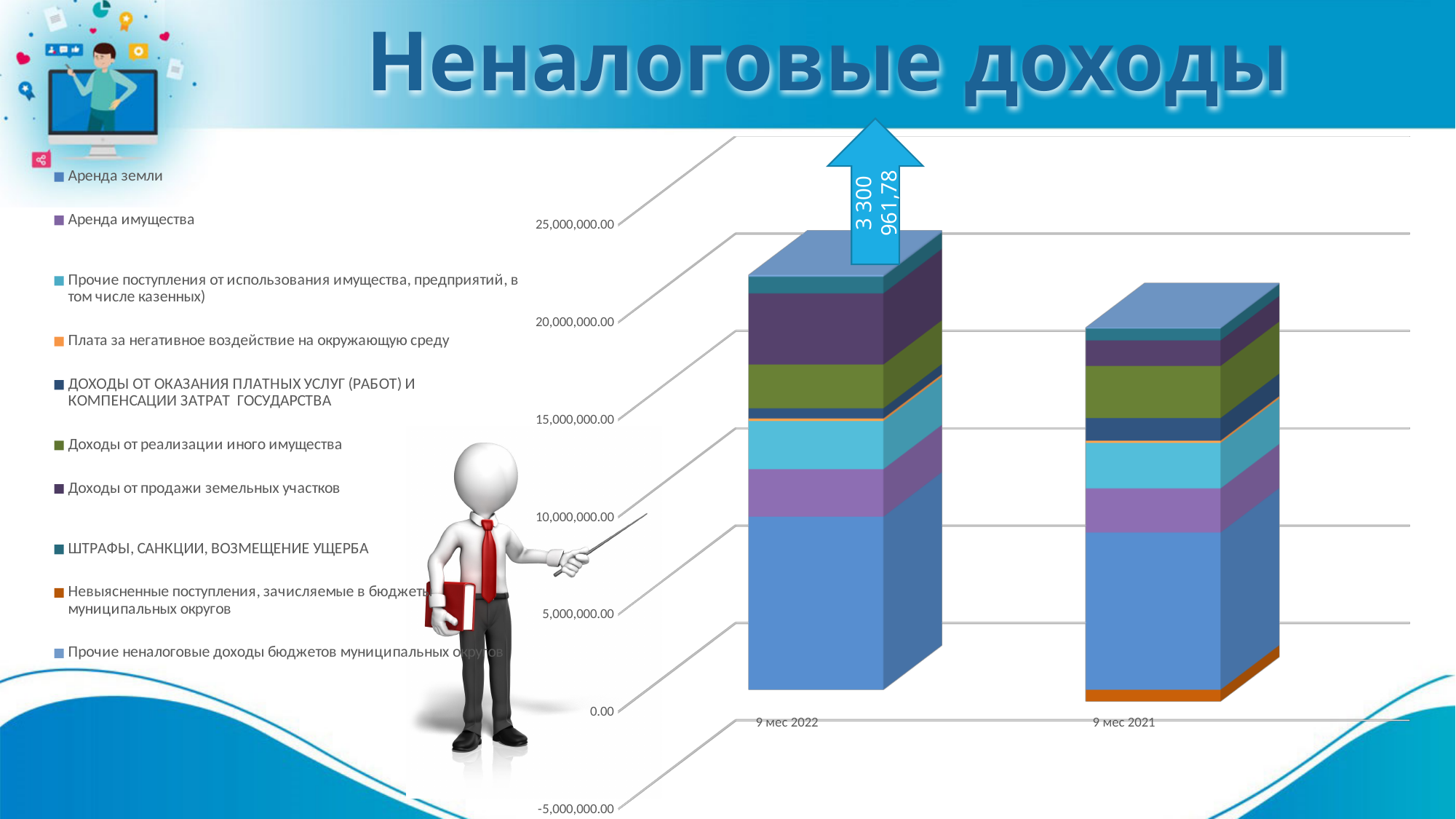
How many series does the chart legend list? 10 How many categories are shown on the x axis of the chart? 2 Which category has the lowest total in the chart? 9 мес 2021 What is the title of the slide containing the chart? Неналоговые доходы What kind of chart is shown on the slide? stacked bar chart Is the total for 9 мес 2022 greater or less than 25,000,000.00? less Do the bar totals rise or fall moving from 9 мес 2022 to 9 мес 2021 along the x axis? fall What value is written on the arrow above the 9 мес 2022 bar? 3 300 961,78 Which category has the highest total in the chart? 9 мес 2022 Is the total for 9 мес 2022 greater or less than 20,000,000.00? greater Is the total for 9 мес 2021 greater or less than 15,000,000.00? greater Which category has the taller stacked bar, 9 мес 2022 or 9 мес 2021? 9 мес 2022